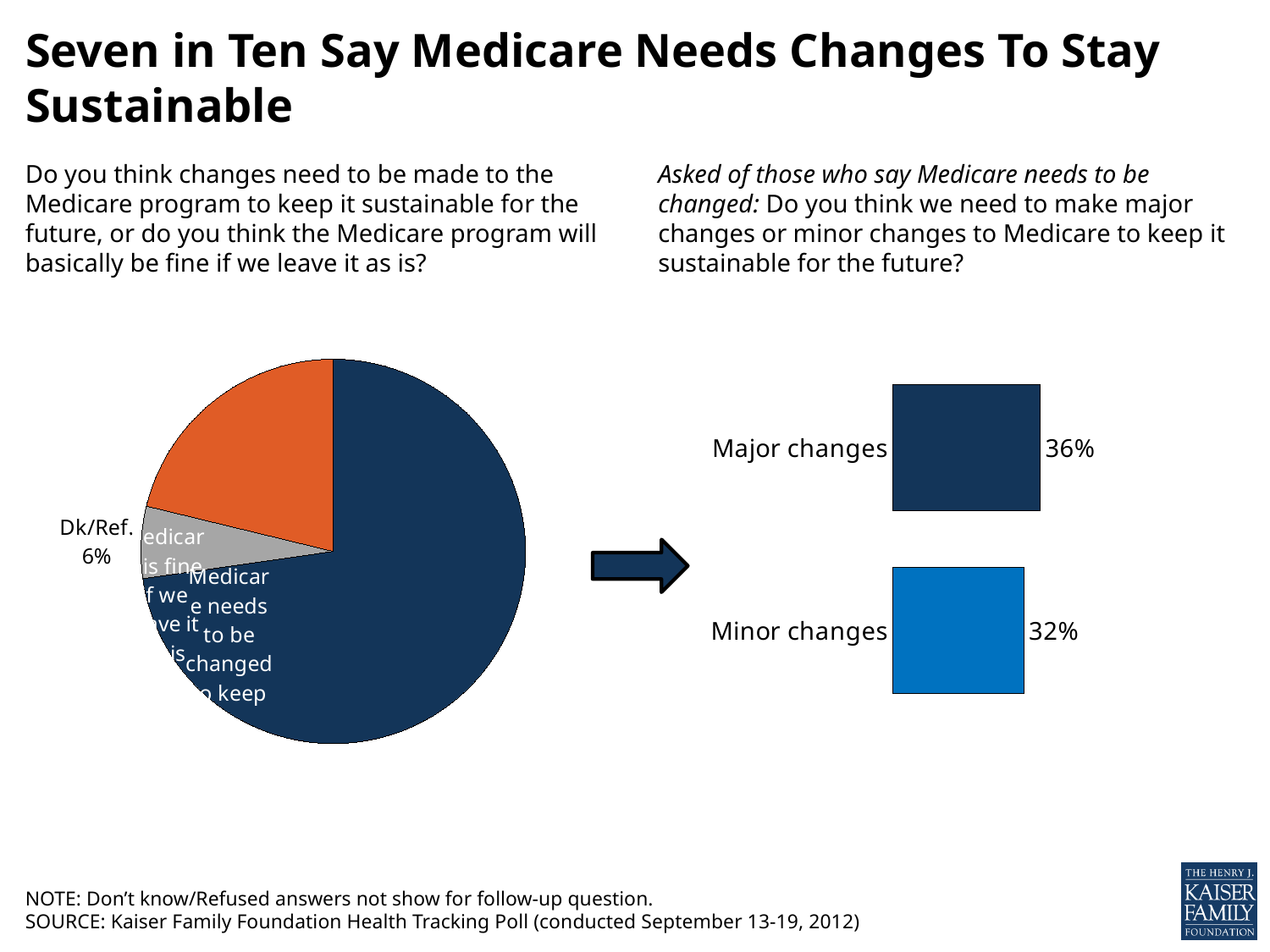
In the pie chart on the left, what percentage is shown for Dk/Ref.? 6% In the bar chart on the right, what percentage say minor changes are needed? 32% In the bar chart on the right, which category has the lower value? Minor changes In the bar chart on the right, is the value for Major changes larger or smaller than the value for Minor changes? larger In the pie chart on the left, which slice is the smallest? Dk/Ref. How many categories are shown in the bar chart on the right? 2 What kind of chart is shown on the right side of the slide? bar chart In the bar chart on the right, which category has the higher value? Major changes How many slices does the pie chart on the left have? 3 In the bar chart on the right, what is the difference between the Major changes and Minor changes values? 4 percentage points What kind of chart is shown on the left side of the slide? pie chart In the bar chart on the right, what percentage say major changes are needed? 36%